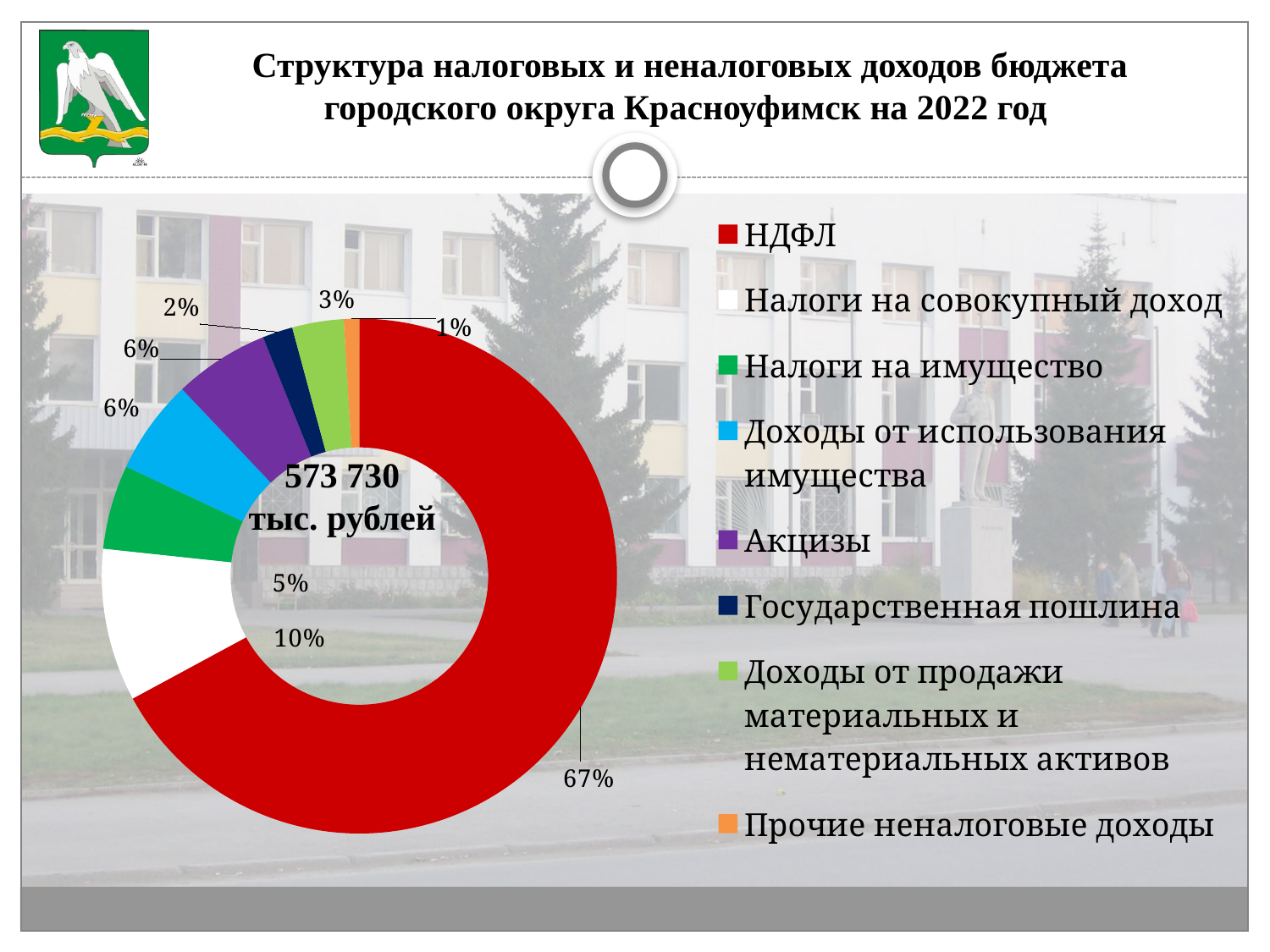
Which category has the largest share of the chart? НДФЛ What share of the budget revenue does НДФЛ account for? 67% What share is shown for Государственная пошлина? 2% What share is shown for Налоги на имущество? 5% Which category has the smallest share of the chart? Прочие неналоговые доходы How many categories does the legend list? 8 What total amount is written in the centre of the doughnut chart? 573 730 тыс. рублей What kind of chart is shown on the slide? doughnut (pie) chart What is the difference in percentage points between НДФЛ and Налоги на совокупный доход? 57 percentage points